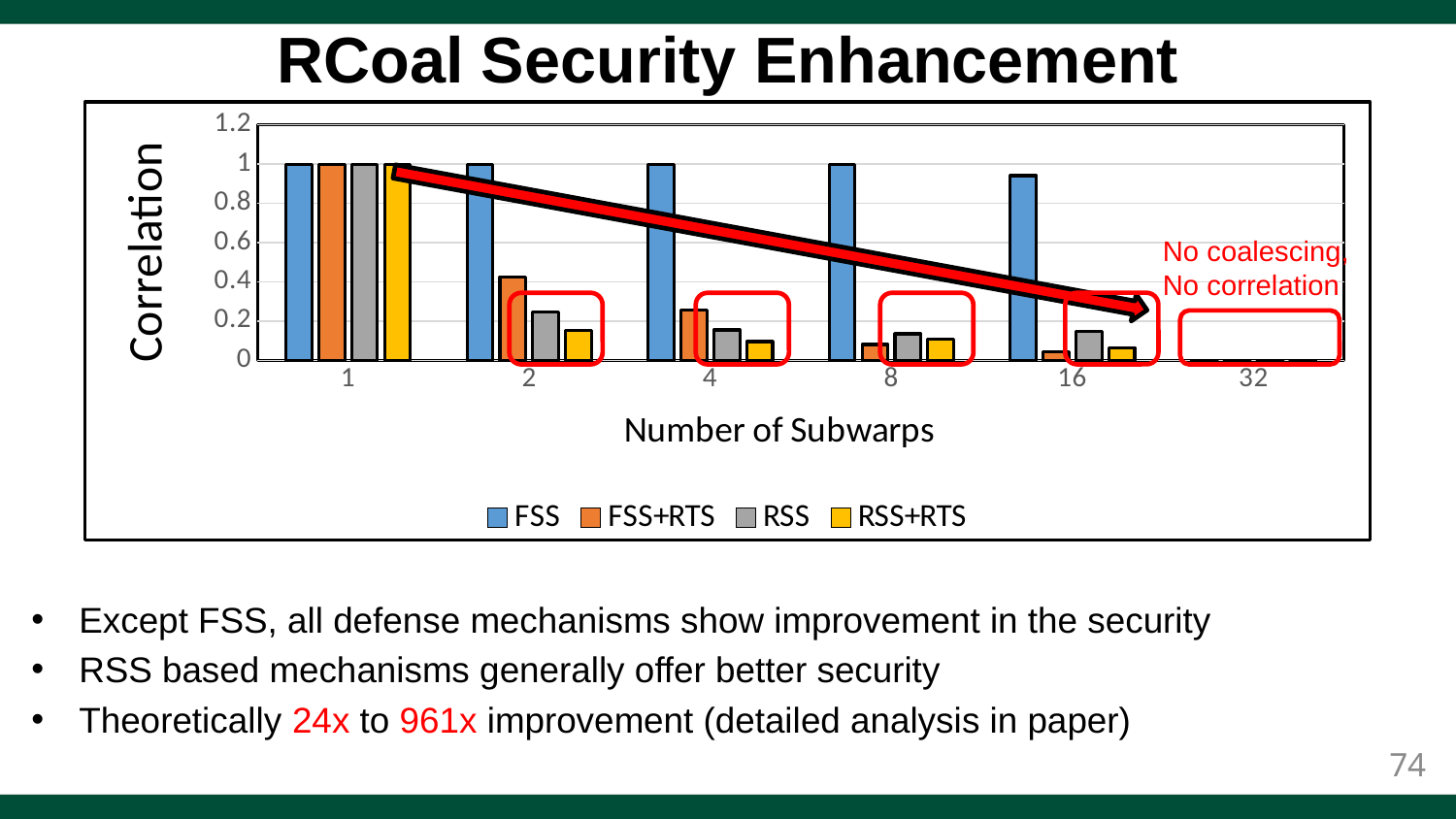
Is the value for RSS+RTS at 4 subwarps greater or less than 0.2? less What kind of chart is shown on the slide? bar chart Which series has the highest Correlation at 2 subwarps? FSS Is the value for FSS+RTS at 2 subwarps greater or less than 0.6? less Which series has the lowest Correlation at 2 subwarps? RSS+RTS At 4 subwarps, which is larger, the value for FSS or the value for RSS? FSS Is the value for FSS at 8 subwarps greater or less than 0.8? greater What is the label of the y axis? Correlation How many series does the legend list? 4 What is the label of the x axis? Number of Subwarps How many Number of Subwarps categories are shown on the x axis? 6